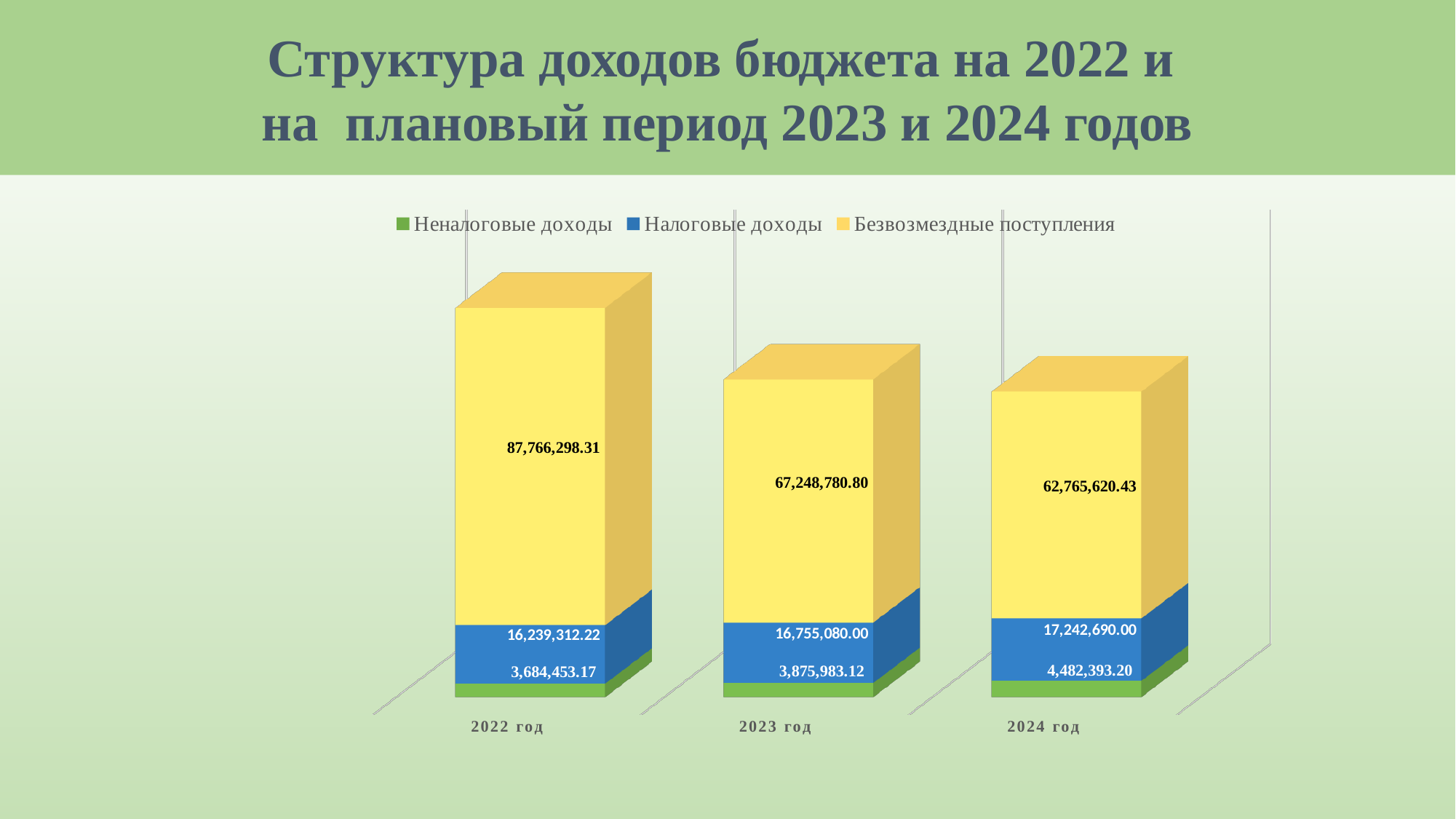
How many series does the legend list? 3 What type of chart is shown on the slide? Stacked bar chart Which is larger: Налоговые доходы in 2024 год or in 2022 год? 2024 год What is the difference between Безвозмездные поступления in 2022 год and 2023 год? 20,517,517.51 What is the value of Налоговые доходы for 2023 год? 16,755,080.00 Do the values of Безвозмездные поступления rise or fall from 2022 год to 2024 год? Fall What is the value of Неналоговые доходы for 2024 год? 4,482,393.20 How many categories (years) are shown on the x axis? 3 In which year is Безвозмездные поступления the highest? 2022 год What is the value of Безвозмездные поступления for 2022 год? 87,766,298.31 In which year is Неналоговые доходы the lowest? 2022 год What is the total of the stacked bar for 2023 год? 87,879,843.92